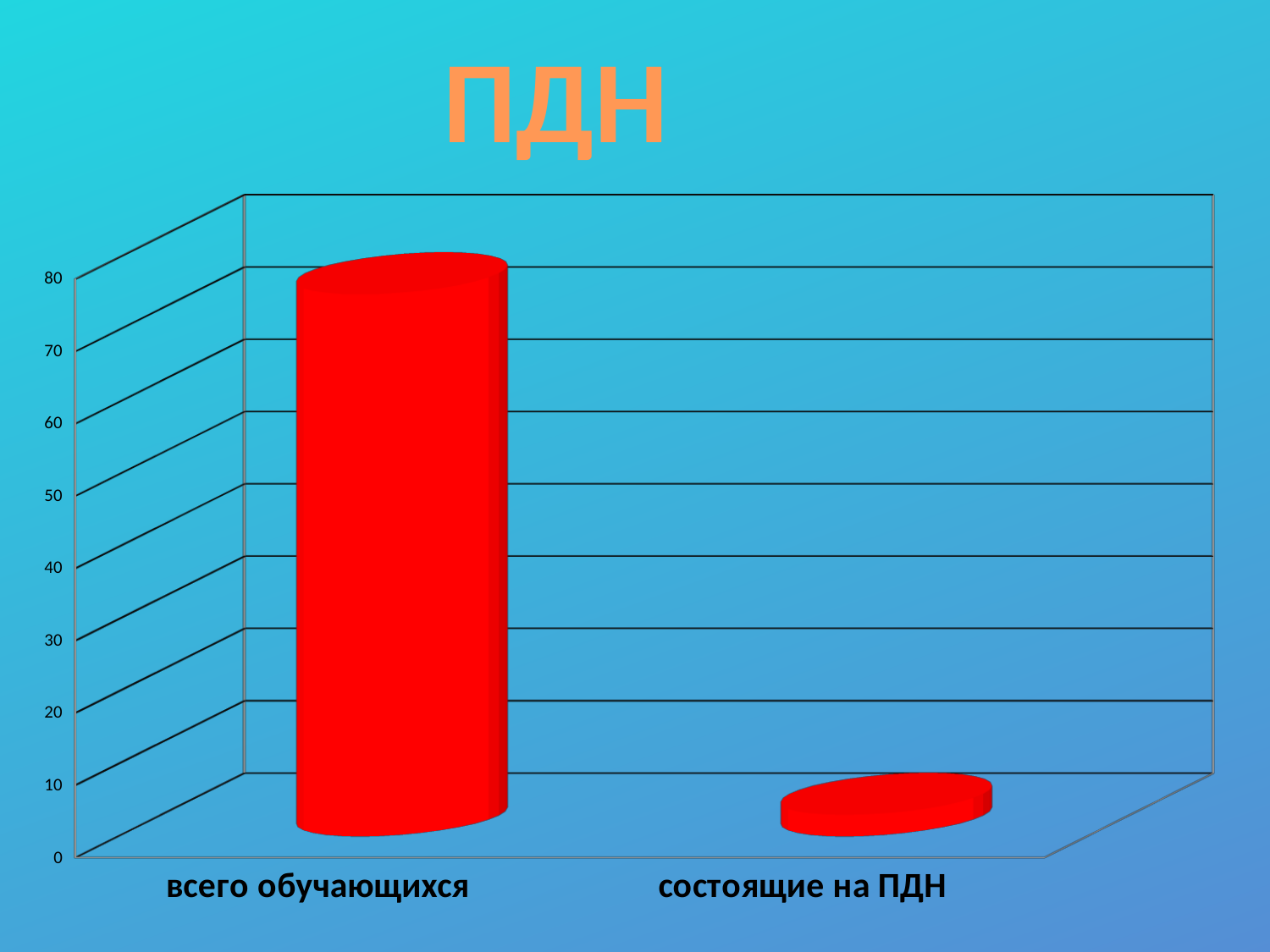
How many categories are shown on the x axis? 2 Which category has the highest value? всего обучающихся Is the value for состоящие на ПДН greater or less than 20? less Is the value for всего обучающихся greater or less than 50? greater What kind of chart is shown on the slide? bar chart Is the value for всего обучающихся greater or less than 70? greater Which category has the lowest value? состоящие на ПДН What is the highest tick value shown on the vertical axis? 80 Which is larger: the value for всего обучающихся or the value for состоящие на ПДН? всего обучающихся What is the title of the chart? ПДН What colour are the bars in the chart? red